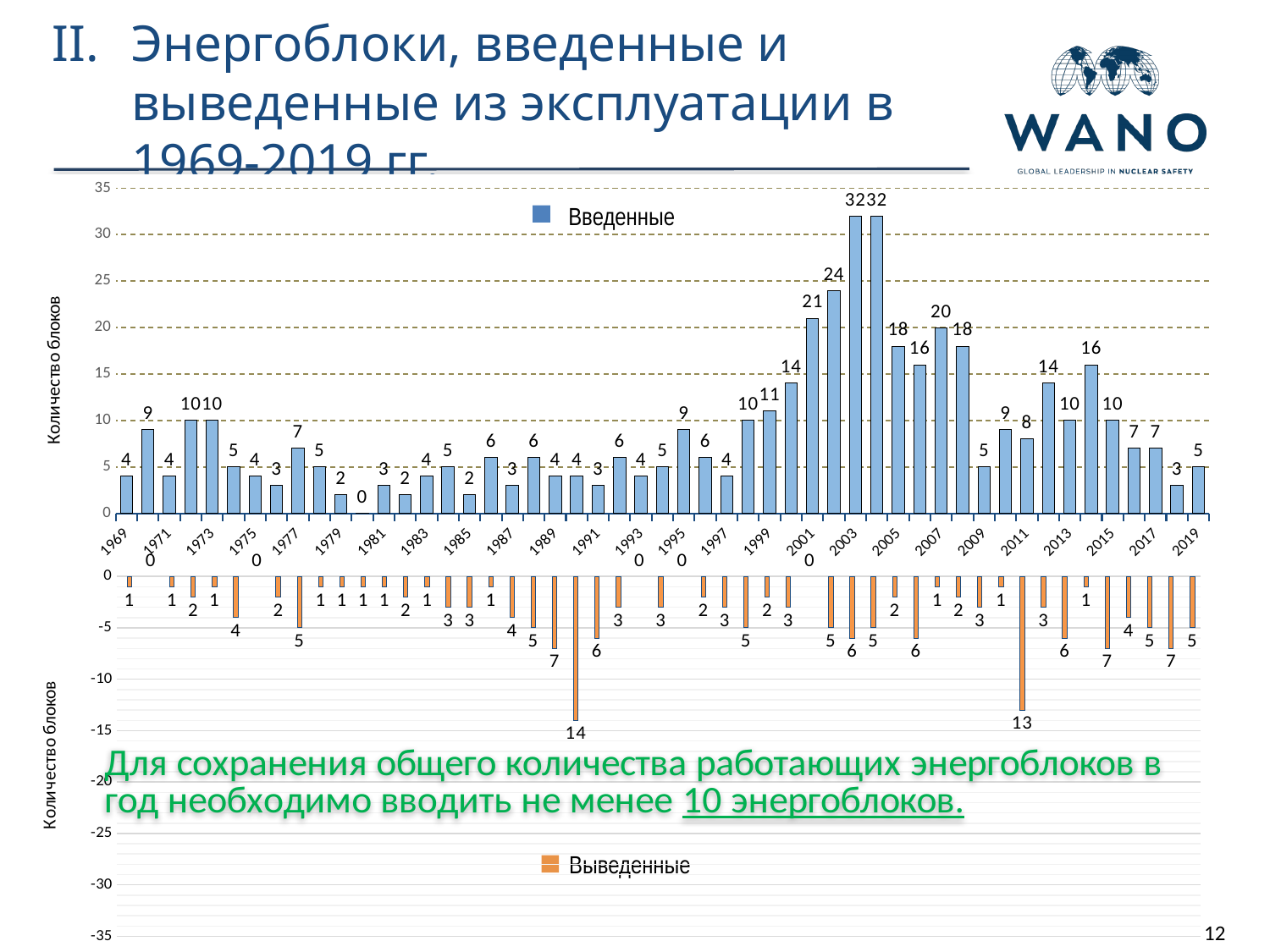
In the bottom chart (Выведенные), what is the value for 2011? 13 In the bottom chart (Выведенные), what is the value for 2019? 5 In the top chart (Введенные), what is the difference between the values for 2003 and 2001? 11 In the top chart (Введенные), which year has the larger value, 1969 or 2019? 2019 In the bottom chart (Выведенные), what is the highest value shown? 14 What kind of chart is used on this slide for the commissioned units (Введенные)? bar chart What is the legend entry of the top chart? Введенные In the top chart (Введенные), what is the value for 1973? 10 In the top chart (Введенные), what is the value for 2001? 21 In the top chart (Введенные), what is the value for 2003? 32 In the top chart (Введенные), what is the highest value shown? 32 In the top chart (Введенные), what is the value for 2019? 5